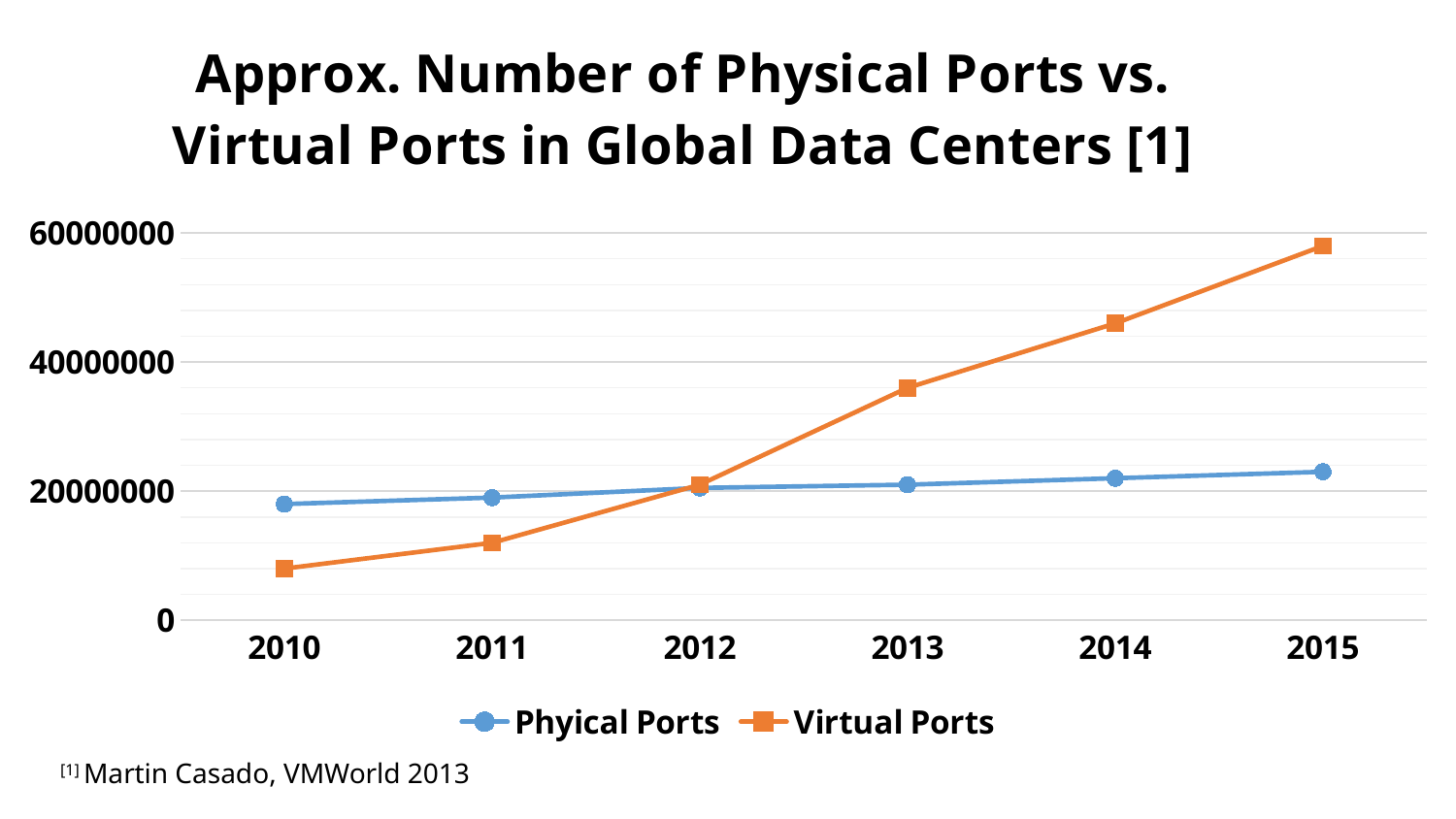
In 2010, which series has the larger value, Physical Ports or Virtual Ports? Physical Ports In 2015, which series has the larger value, Physical Ports or Virtual Ports? Virtual Ports In which year is the Virtual Ports value lowest? 2010 Do the Virtual Ports values rise or fall from 2010 to 2015? Rise How many series does the legend list? 2 Is the Virtual Ports value for 2015 greater or less than 40000000? greater What kind of chart is shown on the slide? Line chart Is the Virtual Ports value for 2010 greater or less than 20000000? less What colour is the Virtual Ports line? Orange In which year is the Virtual Ports value highest? 2015 How many years are plotted along the x axis? 6 Is the Virtual Ports value for 2014 greater or less than 40000000? greater